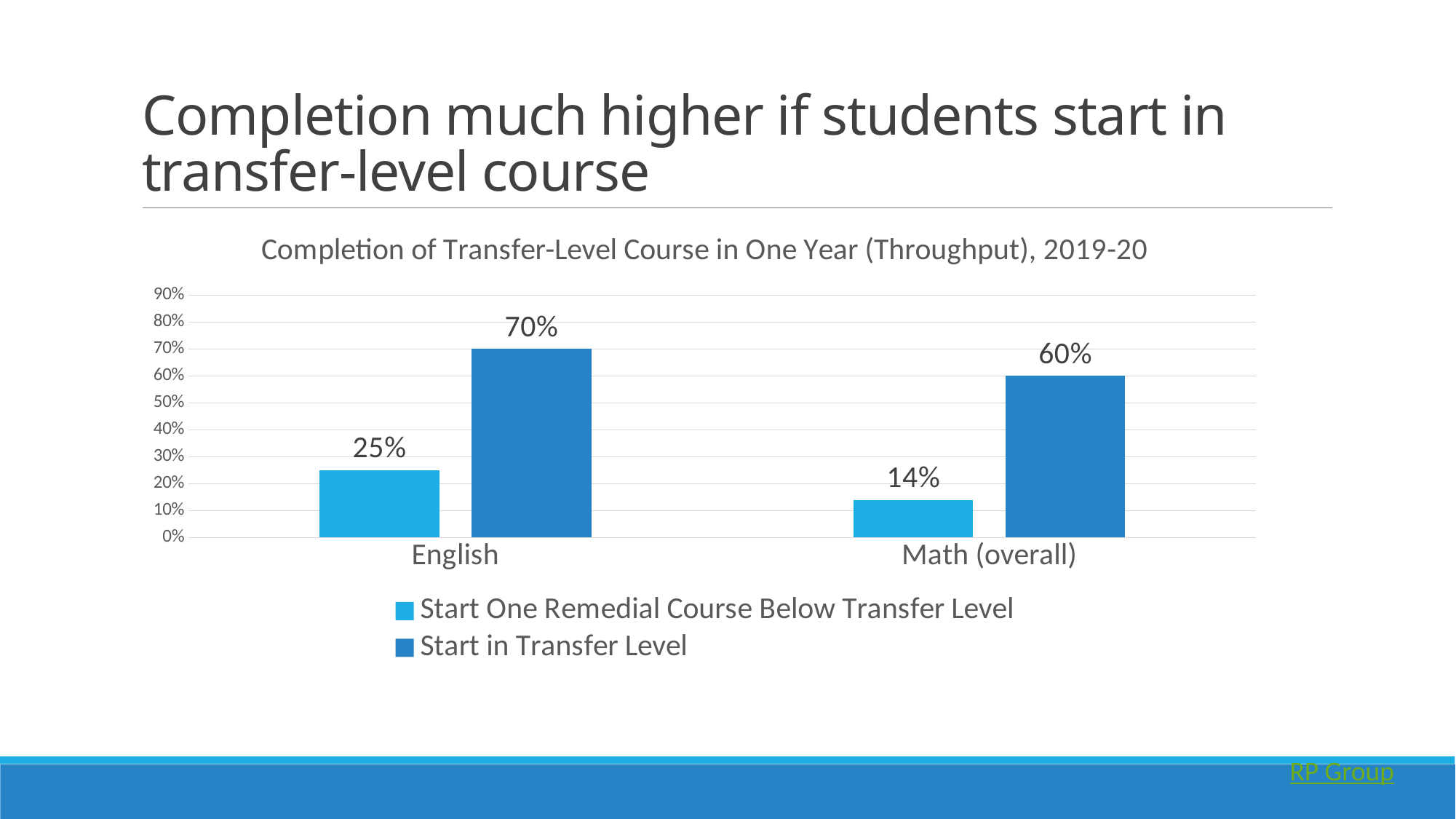
How many categories are shown on the x axis? 2 What is the completion rate for Math (overall) students who start one remedial course below transfer level? 14% Which bar has the highest value on the chart? English, Start in Transfer Level What is the completion rate for English students who start one remedial course below transfer level? 25% What is the completion rate for Math (overall) students who start in transfer level? 60% What is the completion rate for English students who start in transfer level? 70% Which is larger: the Start in Transfer Level rate for English or for Math (overall)? English What type of chart is shown on the slide? Bar chart Which bar has the lowest value on the chart? Math (overall), Start One Remedial Course Below Transfer Level What is the difference between the Start in Transfer Level and Start One Remedial Course Below Transfer Level completion rates for Math (overall)? 46% What is the difference between the Start in Transfer Level and Start One Remedial Course Below Transfer Level completion rates for English? 45% How many series does the legend list? 2